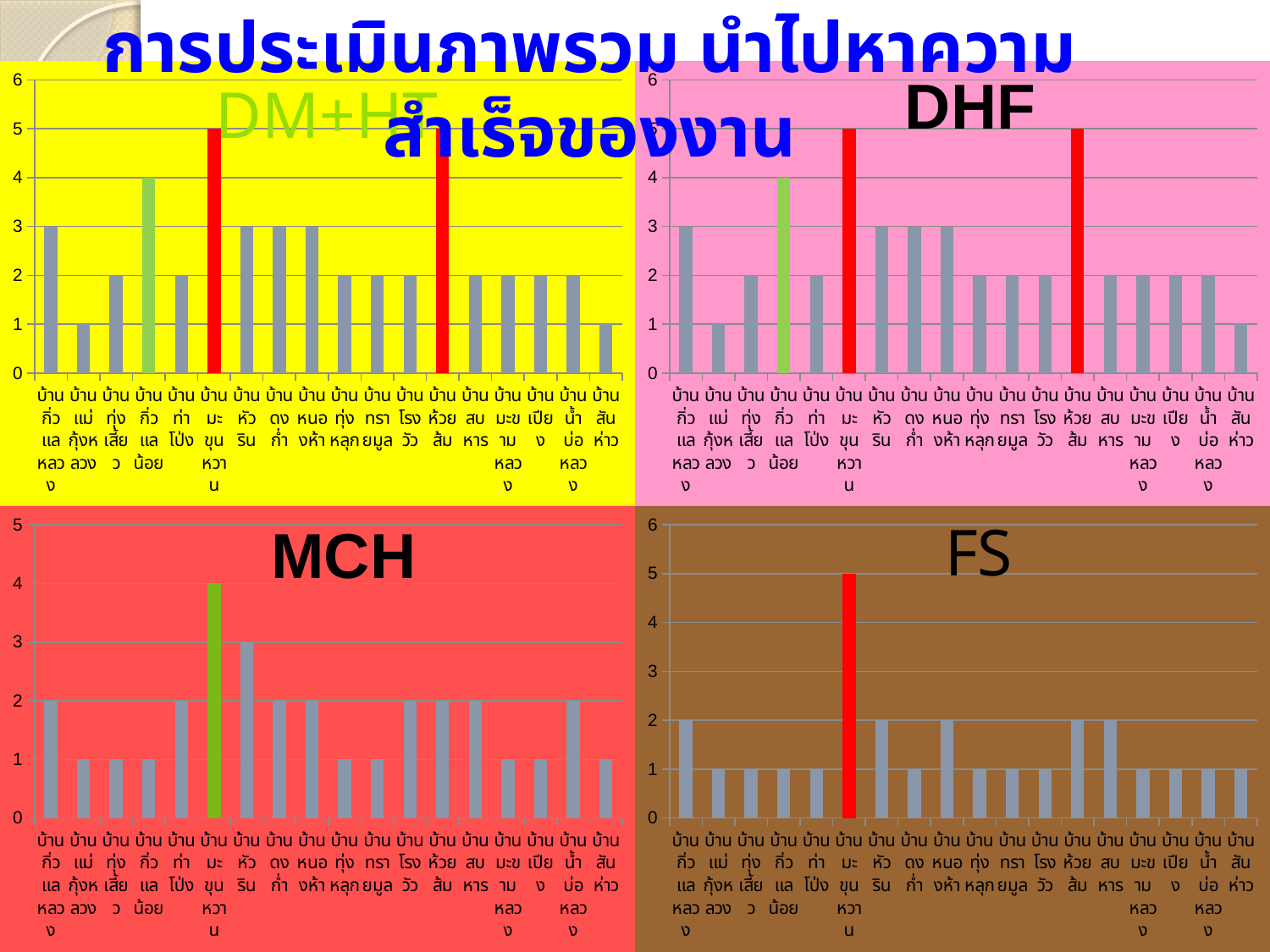
In the MCH chart, what is the value for บ้านหัวริน? 3 In the FS chart, what is the difference between the value for บ้านมะขุนหวาน and the value for บ้านกิ่วแลหลวง? 3 In the MCH chart, what is the value for บ้านสันห่าว? 1 In the MCH chart, which village has the highest value? บ้านมะขุนหวาน What is the title of the chart in the bottom-right of the slide? FS How many categories (villages) are shown on the x axis of the FS chart? 18 In the DM+HT chart, what is the value for บ้านกิ่วแลน้อย? 4 In the FS chart, which village has the highest value? บ้านมะขุนหวาน In the DHF chart, what is the value for บ้านมะขุนหวาน? 5 In the DHF chart, is the value for บ้านห้วยส้ม greater or less than 4? greater What kind of chart is the DM+HT chart? Bar chart In the DM+HT chart, which is larger: the value for บ้านกิ่วแลหลวง or the value for บ้านแม่กุ้งหลวง? บ้านกิ่วแลหลวง